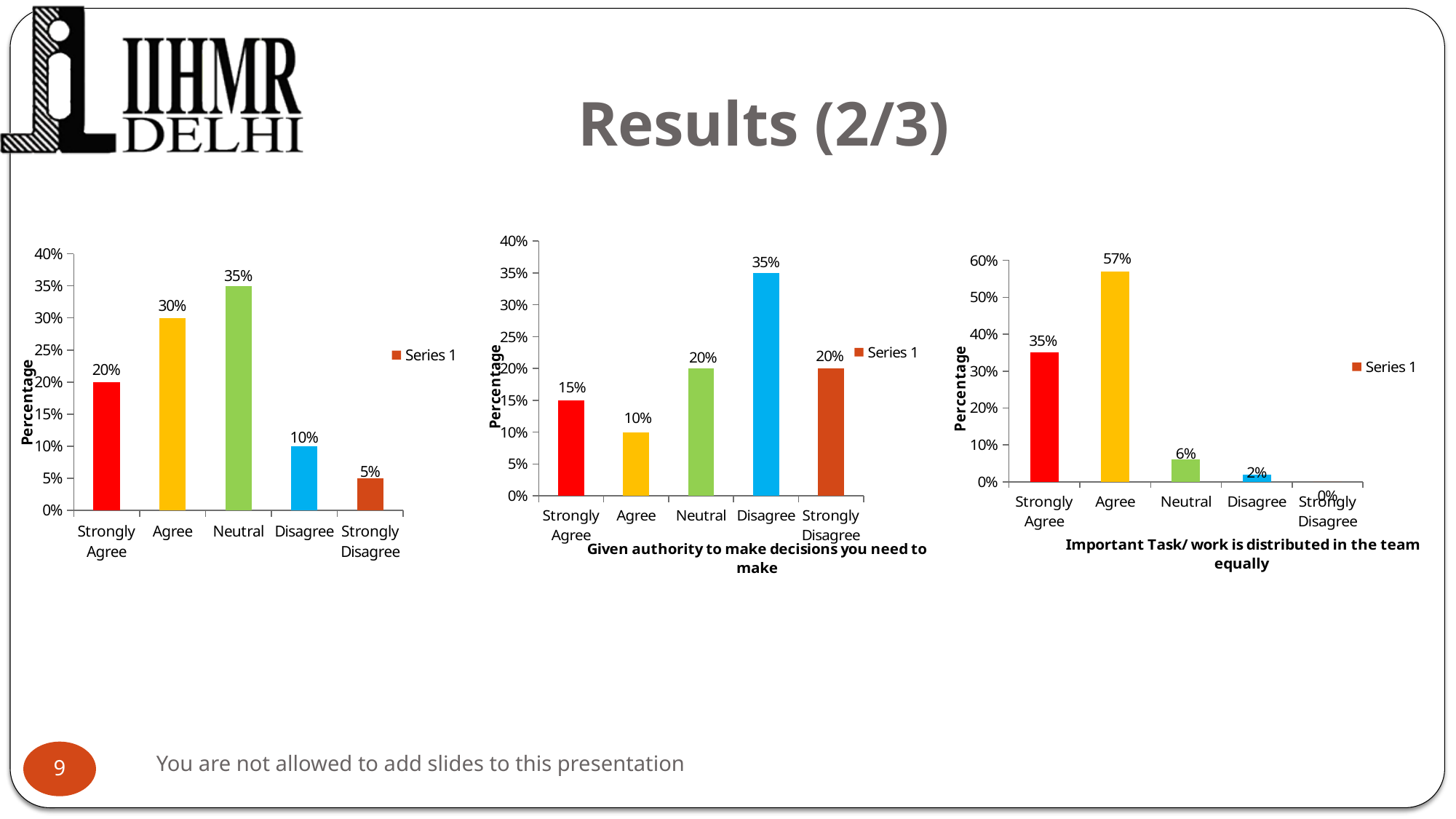
In the chart titled 'Important Task/ work is distributed in the team equally', what is the difference between Strongly Agree and Neutral? 29% In the chart titled 'Given authority to make decisions you need to make', which category has the lowest value? Agree What kind of chart is the left chart? Bar chart In the chart titled 'Given authority to make decisions you need to make', which is larger, Strongly Agree or Neutral? Neutral In the chart titled 'Given authority to make decisions you need to make', what is the value for Disagree? 35% How many series does the legend of the chart titled 'Given authority to make decisions you need to make' list? 1 In the left chart, what is the difference between the values for Agree and Disagree? 20% How many categories are shown on the x axis of the chart titled 'Important Task/ work is distributed in the team equally'? 5 In the chart titled 'Important Task/ work is distributed in the team equally', which category has the highest value? Agree In the chart titled 'Important Task/ work is distributed in the team equally', what is the value for Agree? 57% In the left chart, what is the value for Neutral? 35% In the left chart, which category has the lowest value? Strongly Disagree